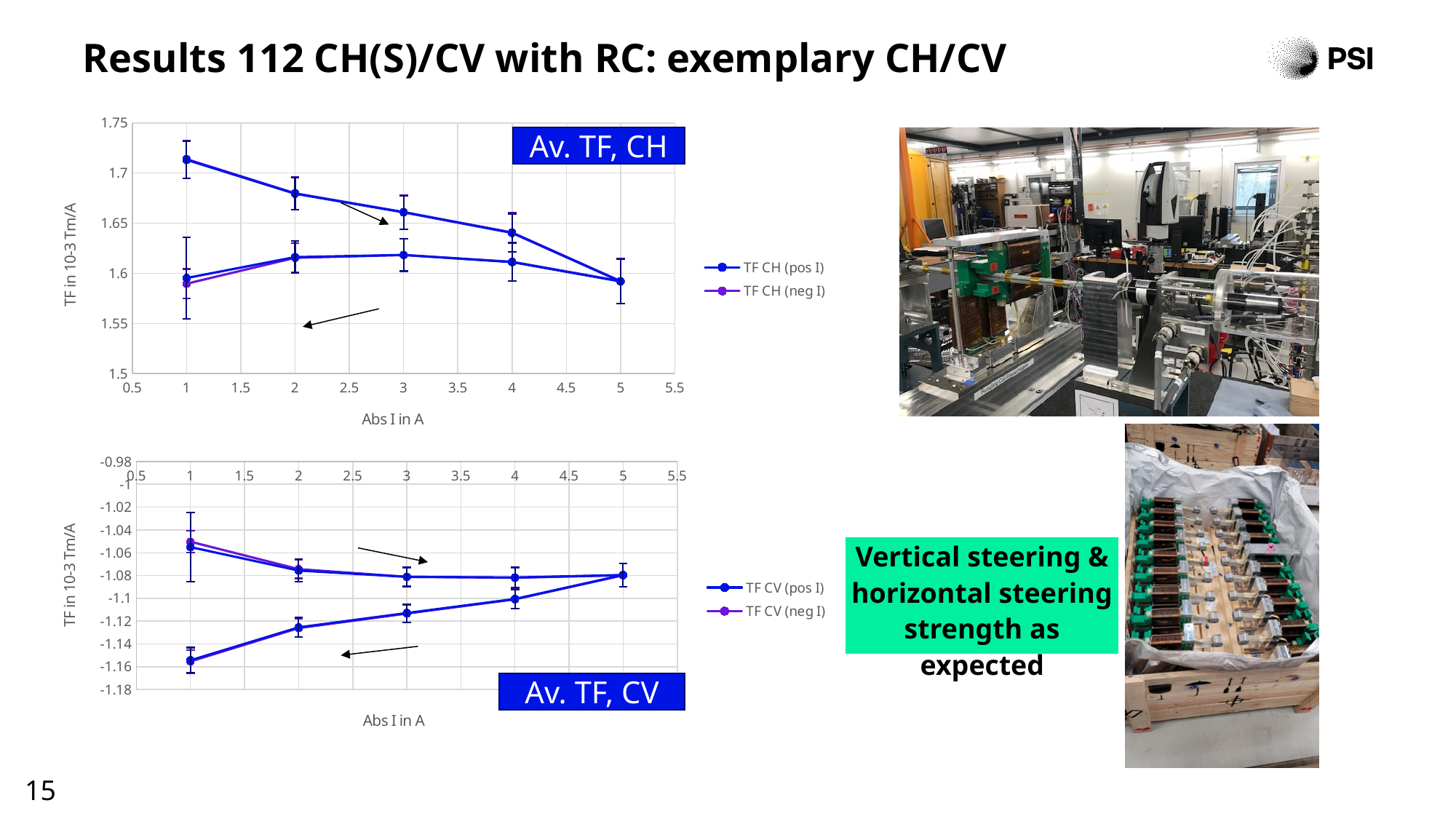
How many series does the legend of the 'Av. TF, CH' chart list? 2 In the 'Av. TF, CH' chart, at how many distinct Abs I values are data points plotted? 5 In the 'Av. TF, CV' chart, is the lowest point at Abs I = 1 A greater or less than -1.14? less How many series does the legend of the 'Av. TF, CV' chart list? 2 In the 'Av. TF, CH' chart, is the highest point at Abs I = 1 A greater or less than 1.65? greater In the 'Av. TF, CV' chart, do the values along the lower branch rise or fall as Abs I increases from 1 A to 5 A? rise In the 'Av. TF, CV' chart, is the value at Abs I = 5 A greater or less than -1.1? greater In the 'Av. TF, CH' chart, at which Abs I value does the highest TF value occur? 1 A What kind of chart is the 'Av. TF, CH' chart at the top left? line chart In the 'Av. TF, CH' chart, do the values along the upper branch rise or fall as Abs I increases from 1 A to 5 A? fall What is the x-axis label of the 'Av. TF, CV' chart? Abs I in A